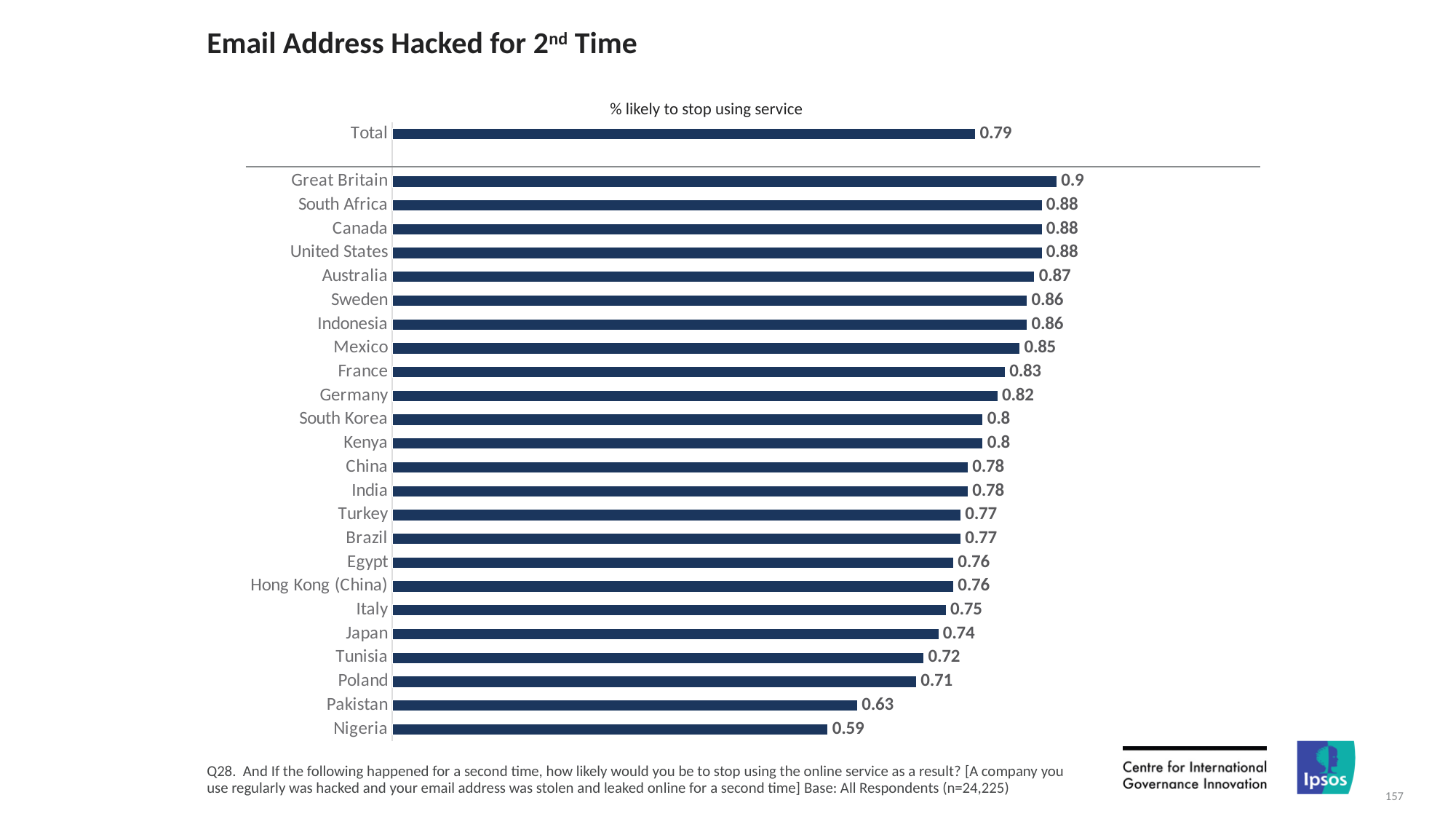
What is the value for Great Britain? 0.9 How many countries are listed below the Total bar? 24 What is the value for Nigeria? 0.59 What kind of chart is shown on the slide? Bar chart Which has a larger value, Mexico or Japan? Mexico What is the value for Hong Kong (China)? 0.76 What is the difference between the values for Great Britain and Nigeria? 0.31 Which country has the lowest value? Nigeria What is the difference between the values for Pakistan and Poland? 0.08 What is the value for Total? 0.79 What is the title shown above the chart's bars? % likely to stop using service Which country has the highest value? Great Britain